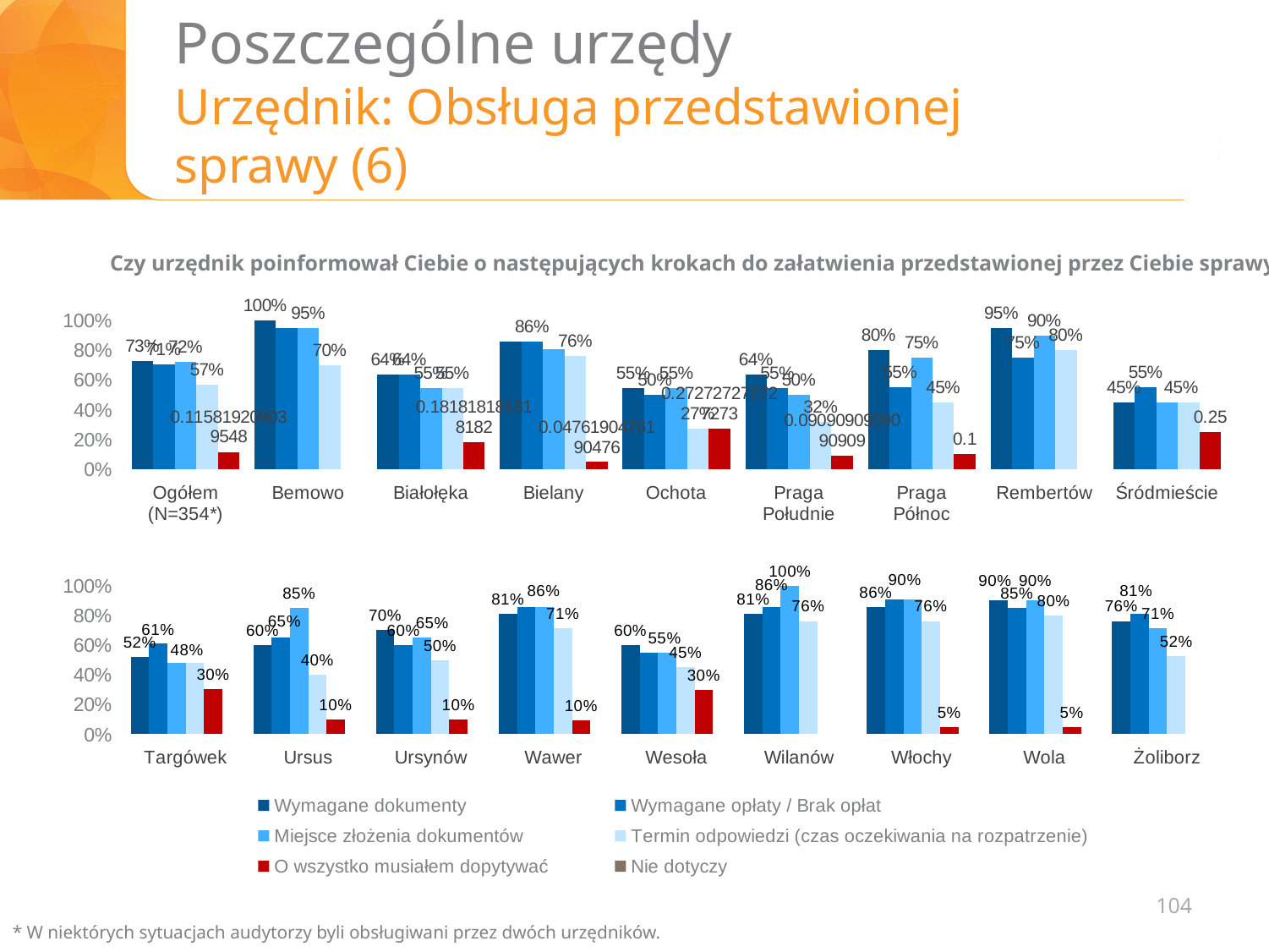
In the bottom chart, what is the value of the red 'O wszystko musiałem dopytywać' bar for Wola? 5% In the bottom chart, which series has the highest value for Ursus? Miejsce złożenia dokumentów How many series does the legend list? 6 In the bottom chart, what is the value for 'Miejsce złożenia dokumentów' in Wilanów? 100% In the bottom chart, how many districts (categories) are shown? 9 In the bottom chart, what is the value of the red 'O wszystko musiałem dopytywać' bar for Targówek? 30% In the top chart, what is the value for 'Wymagane dokumenty' in Bemowo? 100% What kind of chart is used on this slide? bar chart In the top chart, what is the value for 'Wymagane dokumenty' in Rembertów? 95% In the bottom chart, what is the difference between the red 'O wszystko musiałem dopytywać' bars for Targówek (30%) and Wola (5%)? 25 percentage points In the bottom chart, what is the value for 'Wymagane dokumenty' in Ursynów? 70% In the bottom chart, what is the value for 'Miejsce złożenia dokumentów' in Ursus? 85%